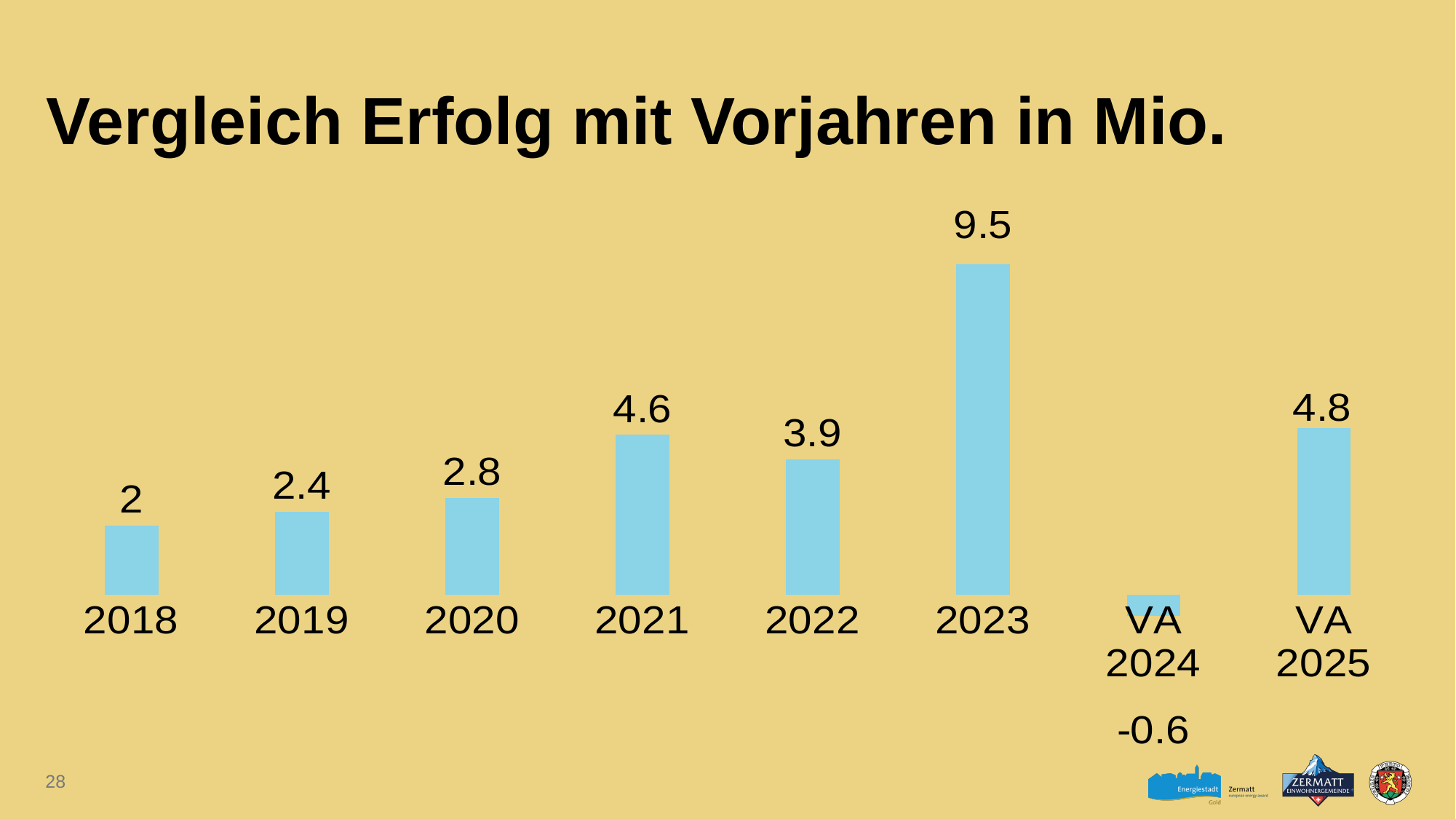
What is the value for VA 2024? -0.6 What is the value for 2020? 2.8 What kind of chart is shown? bar chart Do the values rise or fall from 2018 to 2021? rise Which category has the highest value? 2023 Which category has the lowest value? VA 2024 Which is larger, the value for 2021 or the value for 2022? 2021 What is the difference between the values for 2023 and 2022? 5.6 How many categories are shown on the x axis? 8 What is the title of the chart? Vergleich Erfolg mit Vorjahren in Mio. What is the value for 2023? 9.5 What is the difference between the values for VA 2025 and 2021? 0.2